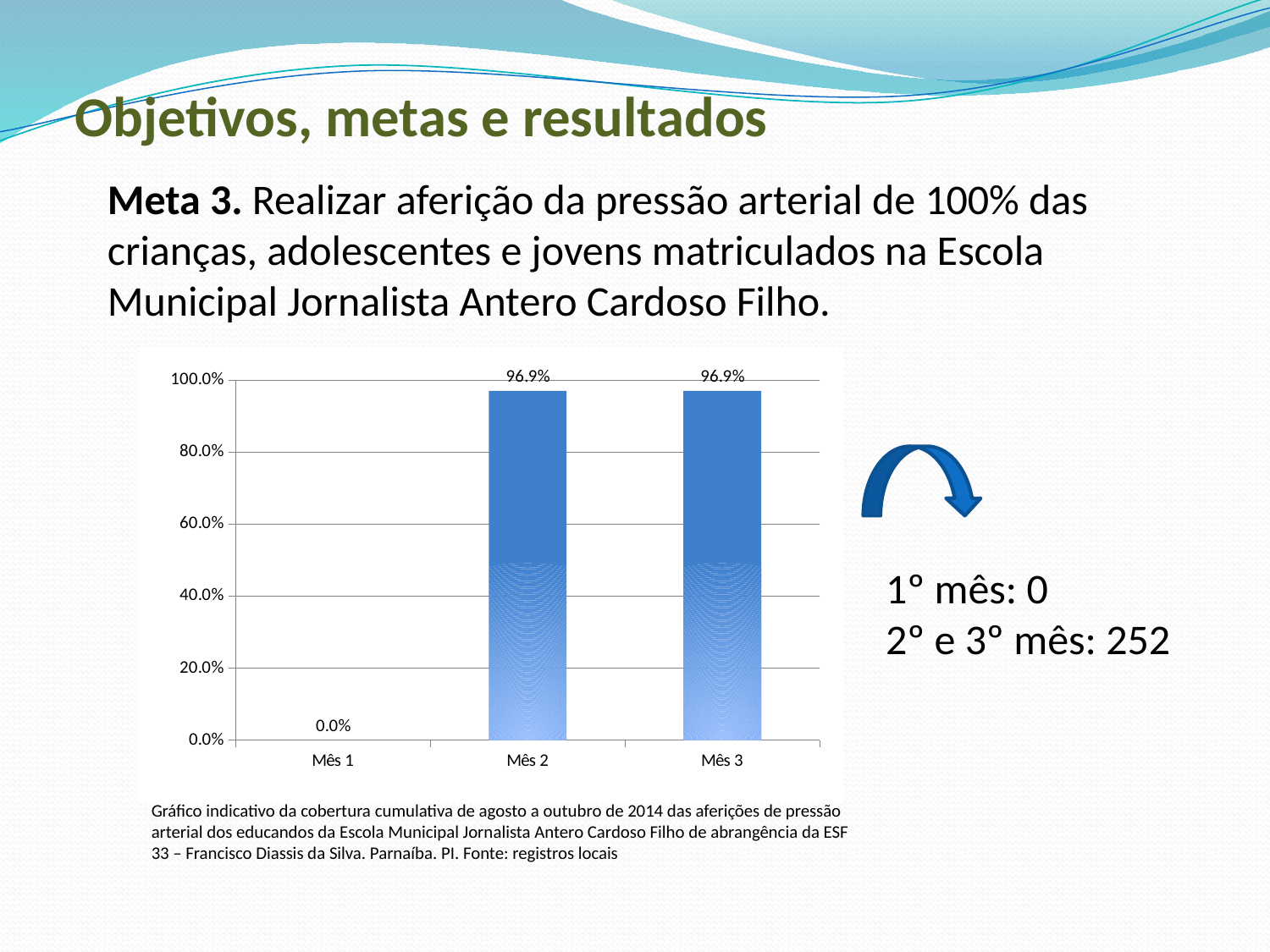
Which is larger, the value for Mês 1 or the value for Mês 3? Mês 3 What is the value for Mês 2? 96.9% Which category has the lowest value? Mês 1 Is the value for Mês 2 greater or less than 80.0%? greater How many categories are shown on the x axis? 3 What kind of chart is shown on the slide? bar chart What is the highest tick value shown on the y axis? 100.0% What is the value for Mês 3? 96.9% Do the values rise or fall from Mês 1 to Mês 2? rise What is the difference between the values for Mês 2 and Mês 1? 96.9% What is the value for Mês 1? 0.0% Are the values for Mês 2 and Mês 3 the same or different? the same